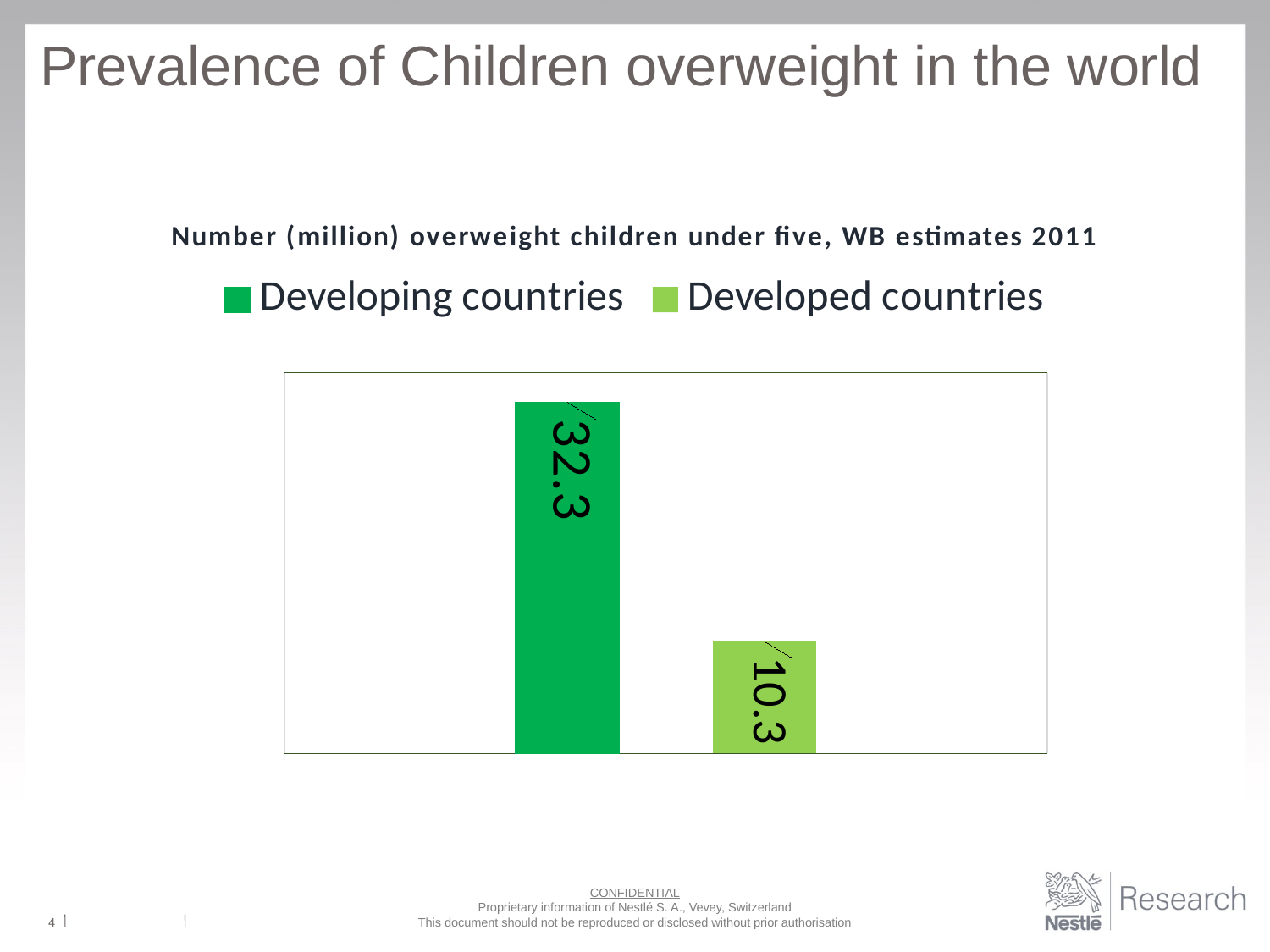
What is the value for Developed countries? 10.3 Which legend entry is shown in the lighter green colour? Developed countries What is the value for Developing countries? 32.3 Which series has the lowest value? Developed countries What kind of chart is shown on the slide? Bar chart What is the difference between the values for Developing countries and Developed countries? 22.0 What is the title of the chart? Number (million) overweight children under five, WB estimates 2011 Which series has the highest value? Developing countries How many series does the legend list? 2 How many bars are plotted on the chart? 2 Which is larger, the value for Developing countries or Developed countries? Developing countries